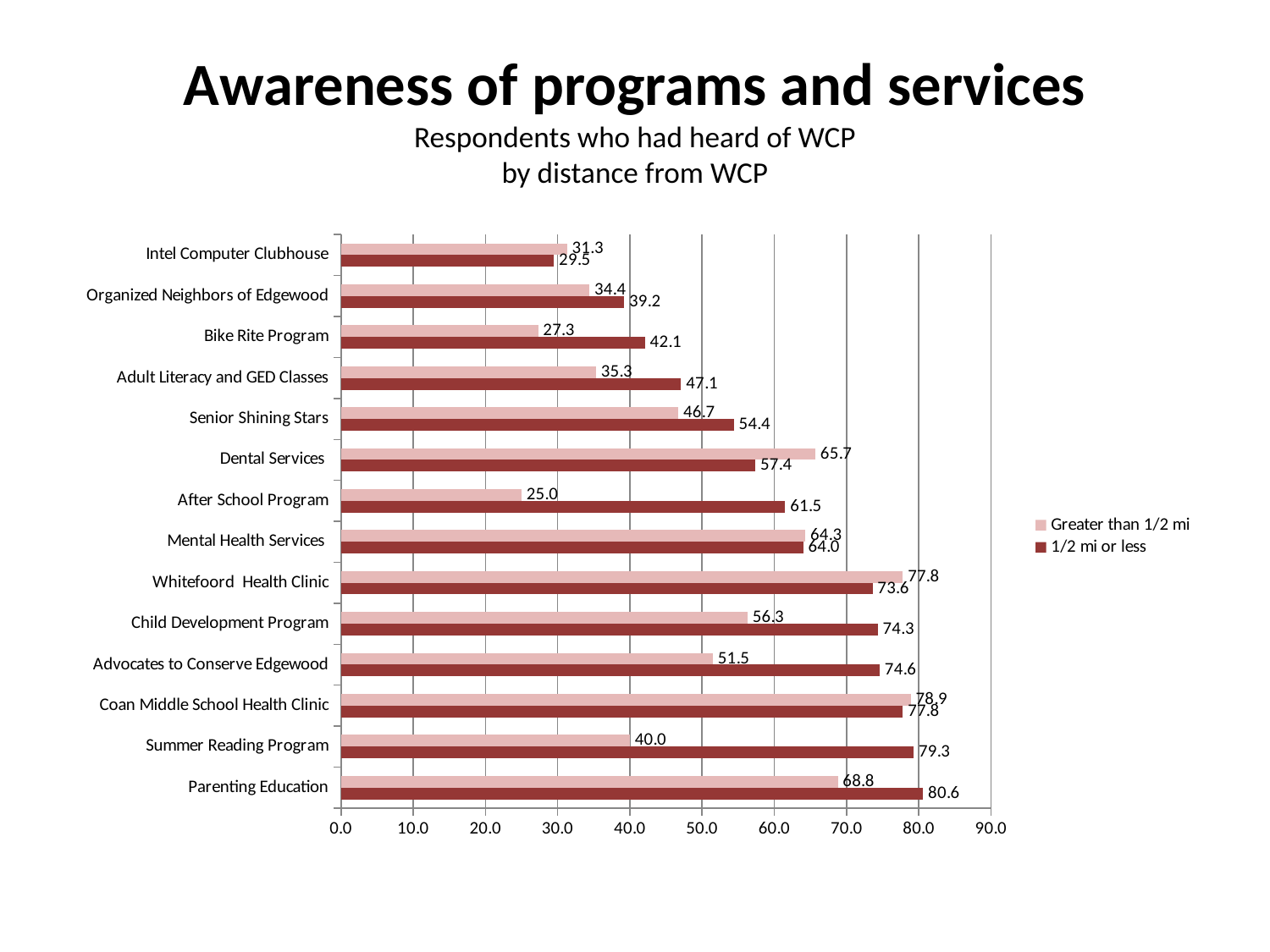
For Dental Services, which series has the larger value: 'Greater than 1/2 mi' or '1/2 mi or less'? Greater than 1/2 mi Which program has the lowest value in the 'Greater than 1/2 mi' series? After School Program Which program has the lowest value in the '1/2 mi or less' series? Intel Computer Clubhouse What is the difference between the '1/2 mi or less' and 'Greater than 1/2 mi' values for Summer Reading Program? 39.3 What is the subtitle shown below the chart title? Respondents who had heard of WCP by distance from WCP What is the value for After School Program in the 'Greater than 1/2 mi' series? 25.0 What is the value for Bike Rite Program in the '1/2 mi or less' series? 42.1 Which program has the highest value in the '1/2 mi or less' series? Parenting Education What type of chart is shown on the slide? Bar chart How many programs or services are listed on the chart? 14 How many series does the legend list? 2 What is the value for Summer Reading Program in the '1/2 mi or less' series? 79.3